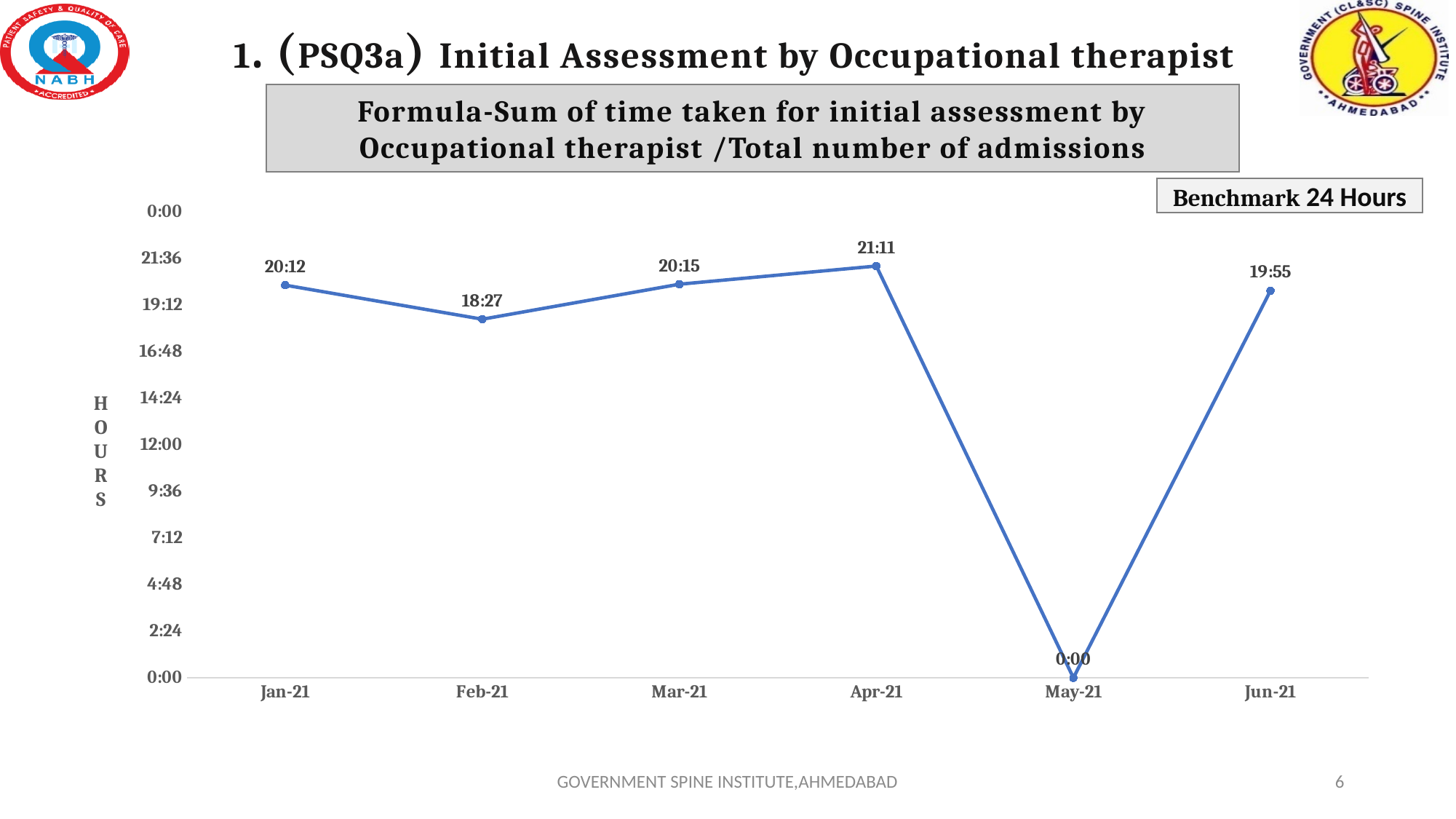
What is the value for Jun-21? 19:55 How many months are plotted on the chart? 6 What kind of chart is shown on the slide? line chart What benchmark is stated on the slide? 24 Hours Is the value for Feb-21 greater or less than 19:12? less What is the value for Feb-21? 18:27 Which month has the lowest value? May-21 Which month has the highest value? Apr-21 Does the value rise or fall from Apr-21 to May-21? fall Which is larger, the value for Apr-21 or the value for Jun-21? Apr-21 What is the value for Apr-21? 21:11 What is the difference between the values for Apr-21 and Feb-21? 2:44